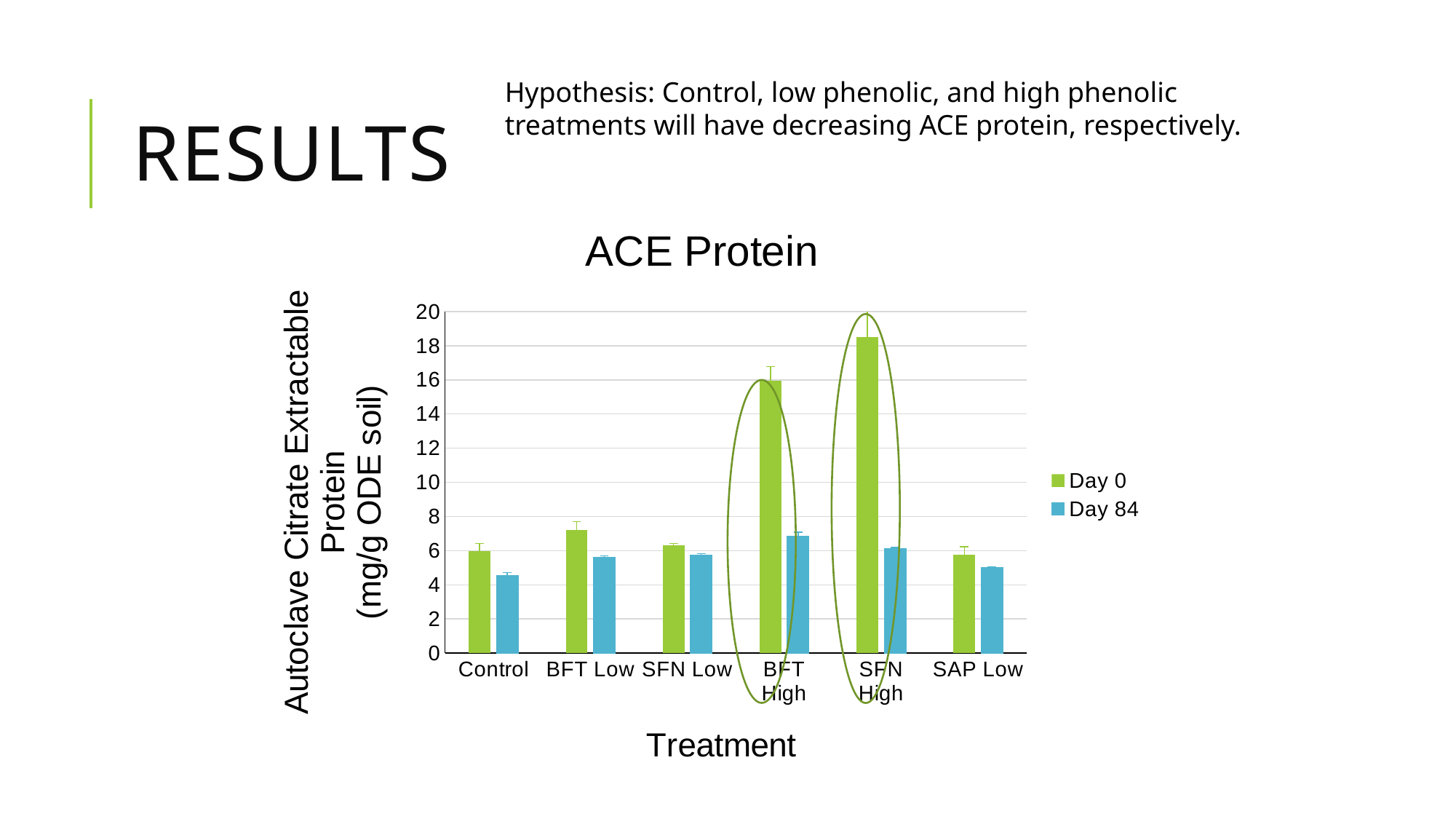
What is the title of the chart? ACE Protein What type of chart is shown on the slide? bar chart How many series does the legend list? 2 Which treatment has the lowest Day 84 value? Control Is the Day 0 value for SFN High greater or less than 16? greater Is the Day 0 value for BFT High greater or less than 14? greater Is the Day 84 value for Control greater or less than 6? less What is the label of the x axis? Treatment Which is larger for SFN High: the Day 0 value or the Day 84 value? Day 0 Which treatment has the highest Day 84 value? BFT High Which treatment has the highest Day 0 value? SFN High How many treatment categories are shown on the x axis? 6